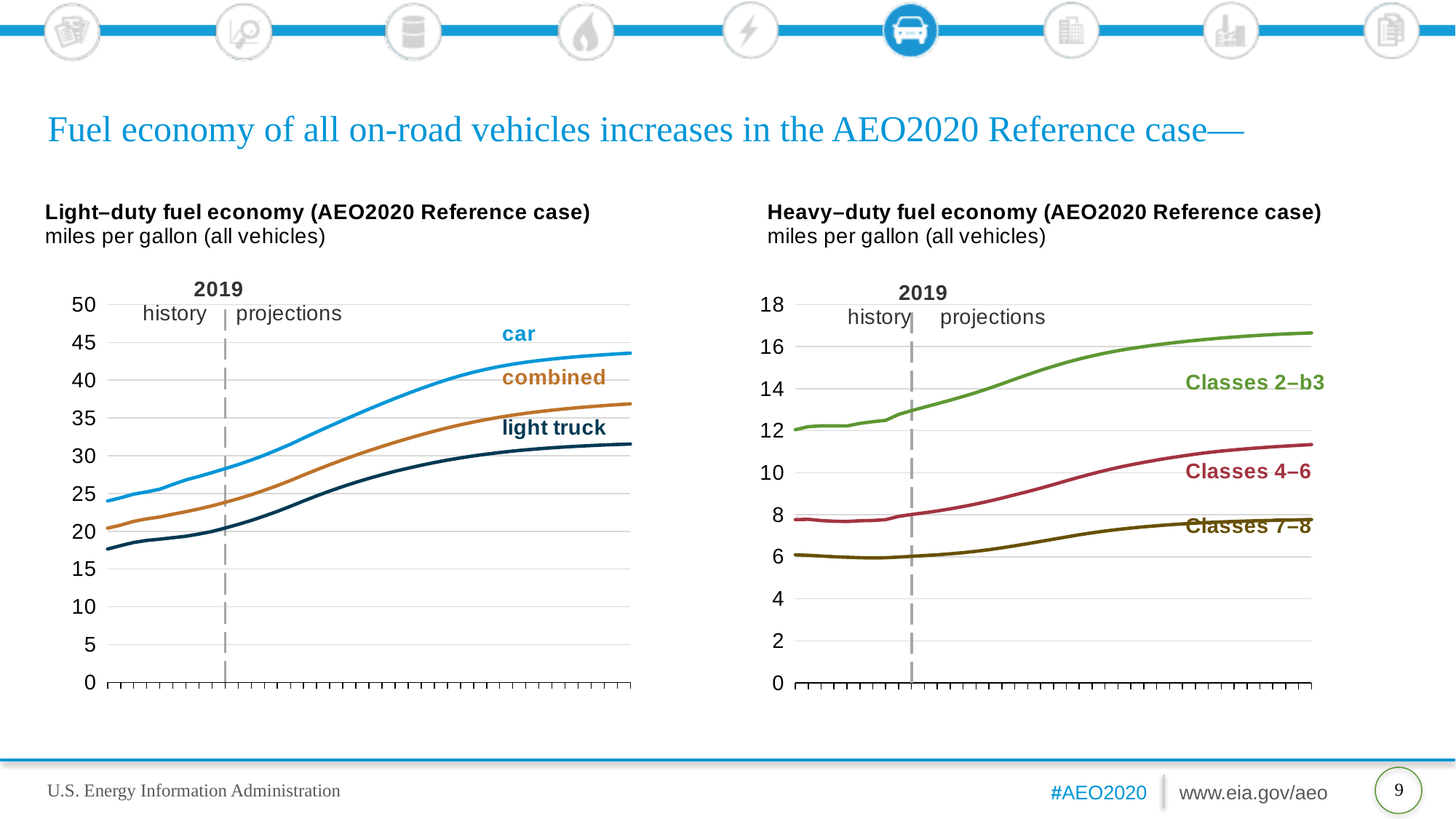
On the Heavy-duty fuel economy chart, is the value for Classes 4-6 at the end of the projection period greater or less than 10? greater On the Light-duty fuel economy chart, is the value for light truck at the end of the projection period greater or less than 30? greater On the Heavy-duty fuel economy chart, which series has the lowest fuel economy? Classes 7–8 What unit is used on the y axis of both charts? miles per gallon On the Light-duty fuel economy chart, which series has the highest fuel economy at the end of the projection period? car On the Light-duty fuel economy chart, is the value for car at the end of the projection period greater or less than 40? greater On the Light-duty fuel economy chart, which series has the lowest fuel economy throughout? light truck How many series are plotted on the Heavy-duty fuel economy chart? 3 How many series are plotted on the Light-duty fuel economy chart? 3 On the Heavy-duty fuel economy chart, which series has the highest fuel economy? Classes 2–b3 What kind of chart is the Light-duty fuel economy chart? line chart On the Heavy-duty fuel economy chart, do the values for Classes 2-b3 rise or fall over the projection period? rise